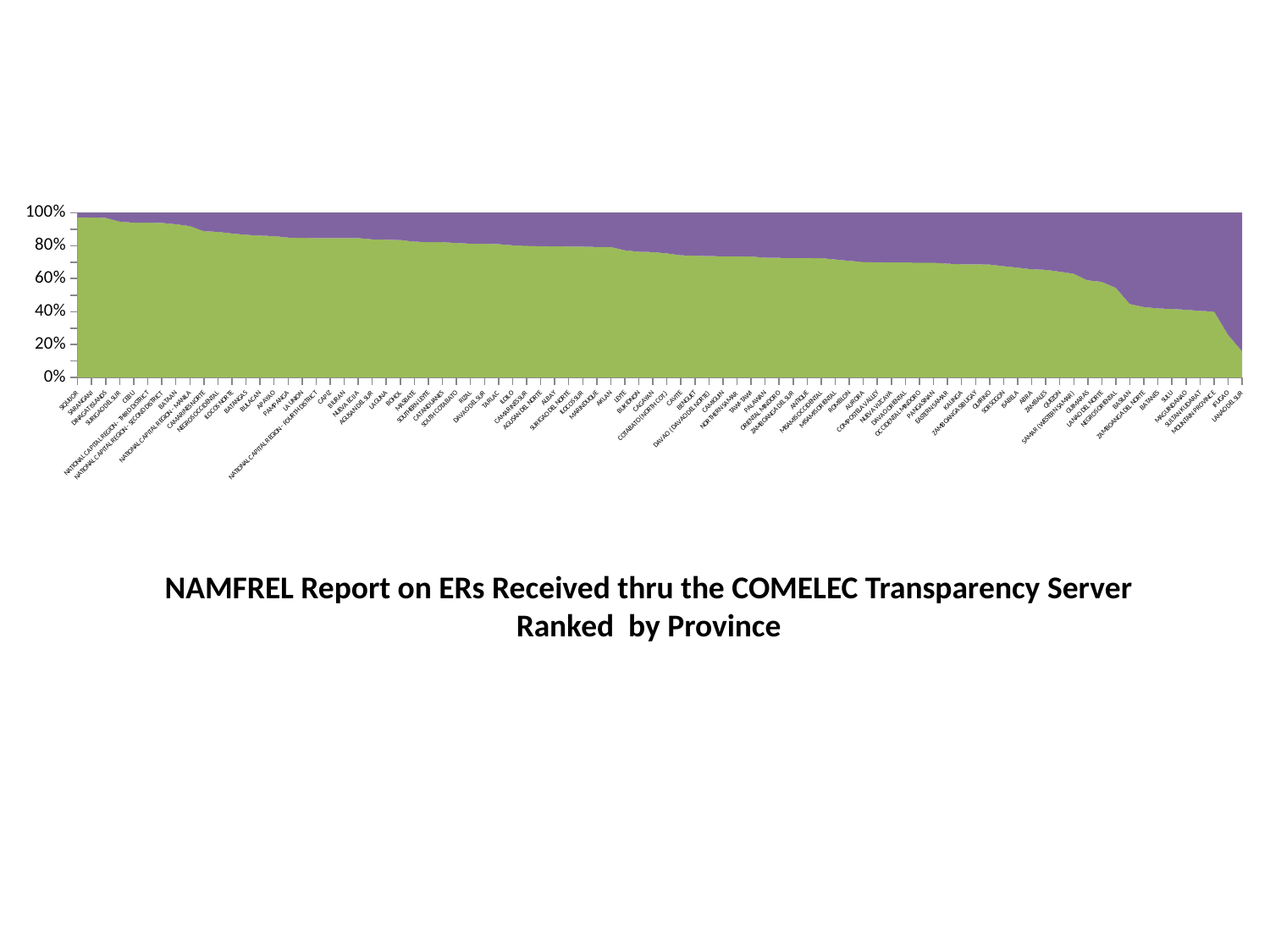
Is the green share for CEBU greater or less than 80%? greater Does the green area's share rise or fall moving from left to right along the x axis? fall Which has the larger green share, CEBU or LANAO DEL SUR? CEBU Which two colours are used for the areas in the chart? green and purple Is the green share for LANAO DEL SUR greater or less than 40%? less What kind of chart is shown on the slide? area chart Is the green share for BULACAN greater or less than 60%? greater What is the highest value shown on the y axis? 100% Which province has the lowest green share in the chart? LANAO DEL SUR What is the title of the chart on the slide? NAMFREL Report on ERs Received thru the COMELEC Transparency Server Ranked by Province